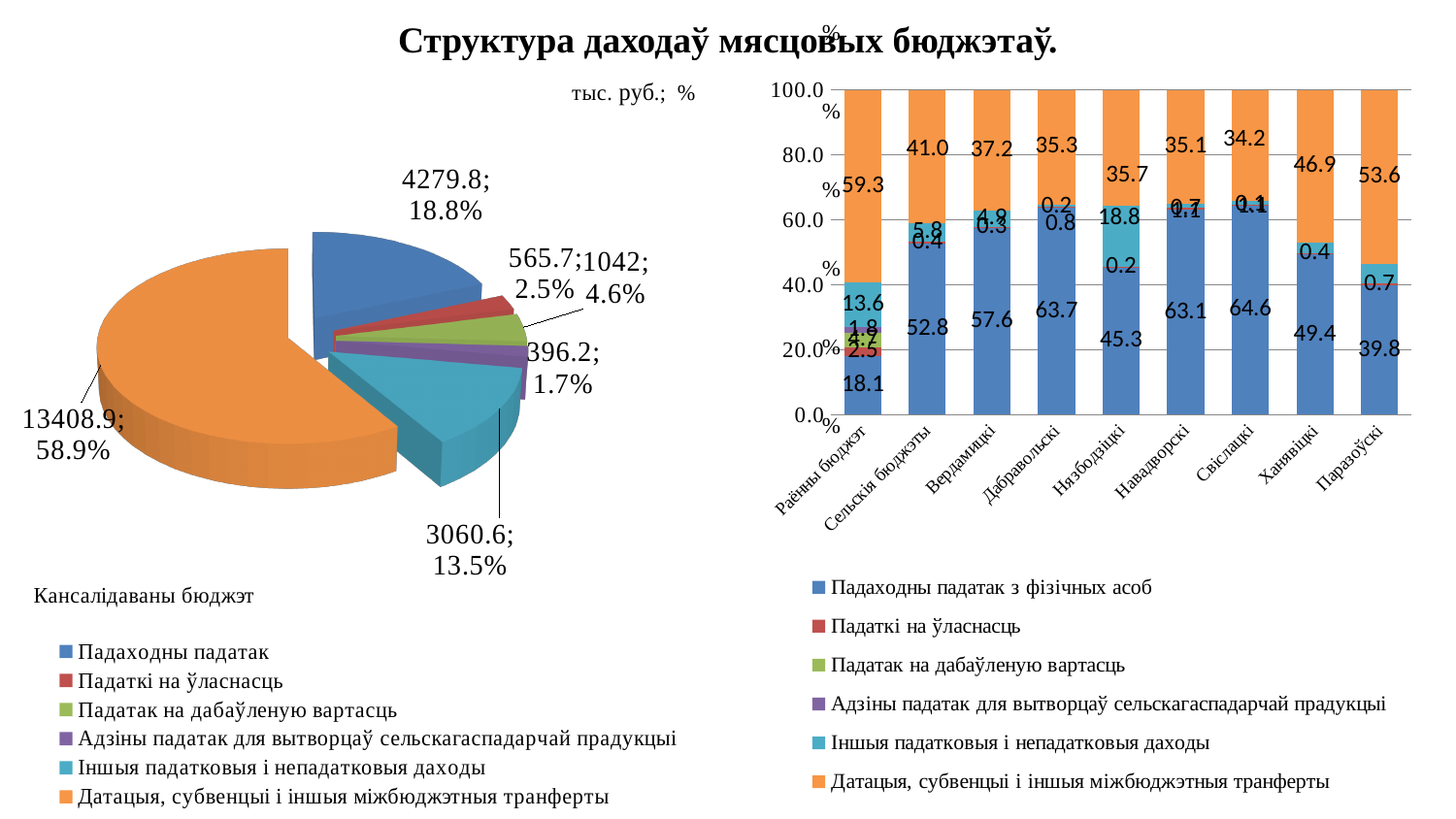
In the bar chart on the right, what is the value of Датацыі, субвенцыі і іншыя міжбюджэтныя трансферты for Паразоўскі? 53.6 In the pie chart on the left, what is the value shown for Іншыя падатковыя і непадатковыя даходы? 3060.6 In the bar chart on the right, how many series does the legend list? 6 In the pie chart on the left, which category has the smallest slice? Адзіны падатак для вытворцаў сельскагаспадарчай прадукцыі In the bar chart on the right, what is the difference between the Датацыі values for Раённы бюджэт (59.3) and Сельскія бюджэты (41.0)? 18.3 In the pie chart on the left, what value and share are shown for Датацыі, субвенцыі і іншыя міжбюджэтныя трансферты? 13408.9; 58.9% In the pie chart on the left, what share does Падаходны падатак have? 18.8% In the bar chart on the right, which category has the lowest value for Падаходны падатак з фізічных асоб? Раённы бюджэт What kind of chart is the chart on the right? Stacked bar chart In the bar chart on the right, how many categories are shown on the x axis? 9 How many slices does the pie chart on the left have? 6 In the bar chart on the right, what is the value of Падаходны падатак з фізічных асоб for Свіслацкі? 64.6